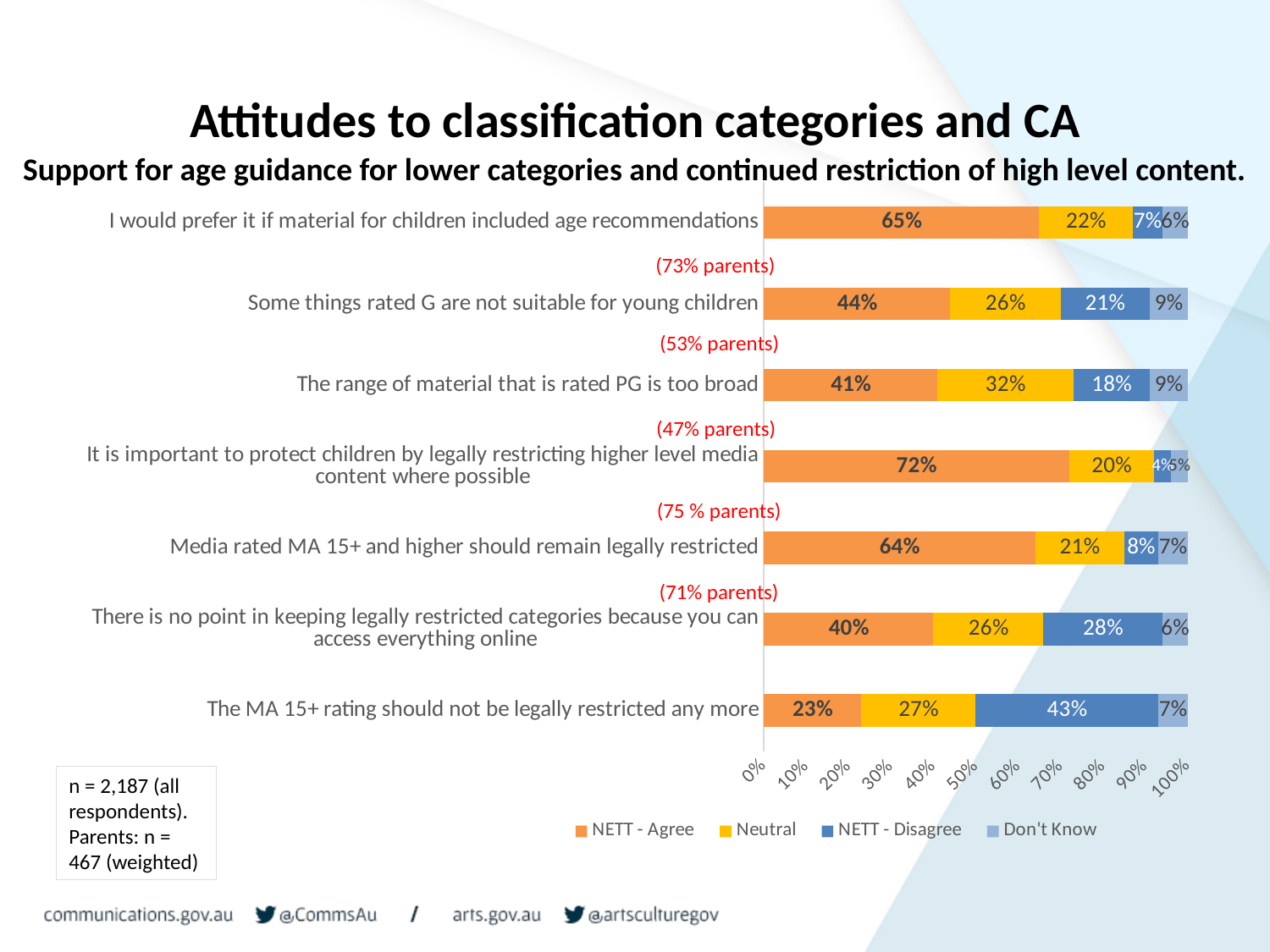
What is the total of the NETT - Agree and Neutral values for 'The MA 15+ rating should not be legally restricted any more'? 50% What is the Don't Know value for 'Some things rated G are not suitable for young children'? 9% What is the difference between the NETT - Agree values for 'I would prefer it if material for children included age recommendations' and 'Some things rated G are not suitable for young children'? 21% How many statements are plotted in the chart? 7 What is the NETT - Disagree value for 'The MA 15+ rating should not be legally restricted any more'? 43% Which statement has the lowest NETT - Agree value? The MA 15+ rating should not be legally restricted any more What kind of chart is shown on the slide? Stacked bar chart What percentage of respondents are NETT - Agree that media rated MA 15+ and higher should remain legally restricted? 64% What is the Neutral value for 'The range of material that is rated PG is too broad'? 32% Which statement has the highest NETT - Agree value? It is important to protect children by legally restricting higher level media content where possible Which is larger: the NETT - Disagree value for 'There is no point in keeping legally restricted categories because you can access everything online' or the NETT - Disagree value for 'Some things rated G are not suitable for young children'? There is no point in keeping legally restricted categories because you can access everything online How many series does the legend list? 4